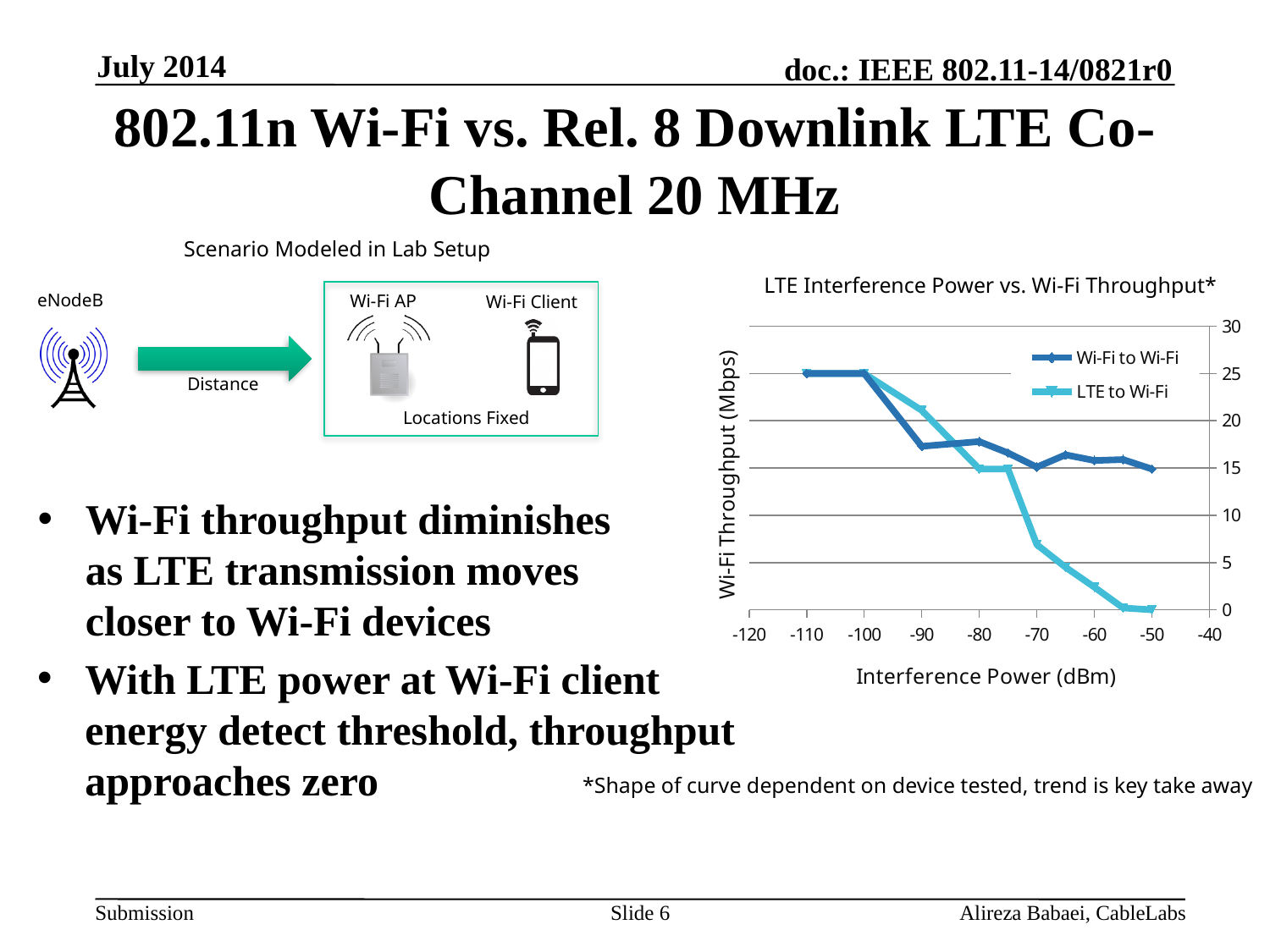
What is the title of the chart? LTE Interference Power vs. Wi-Fi Throughput* Is the Wi-Fi to Wi-Fi throughput at -50 dBm greater or less than 10 Mbps? greater What kind of chart is shown on the slide? line chart Is the LTE to Wi-Fi throughput at -80 dBm greater or less than 20 Mbps? less Does the LTE to Wi-Fi throughput rise or fall as interference power increases from -110 dBm to -50 dBm? fall At -60 dBm interference power, which series has the higher Wi-Fi throughput, Wi-Fi to Wi-Fi or LTE to Wi-Fi? Wi-Fi to Wi-Fi Which series ends with the lower throughput at -50 dBm? LTE to Wi-Fi Is the LTE to Wi-Fi throughput at -60 dBm greater or less than 5 Mbps? less What is the label of the chart's x axis? Interference Power (dBm) How many series does the chart legend list? 2